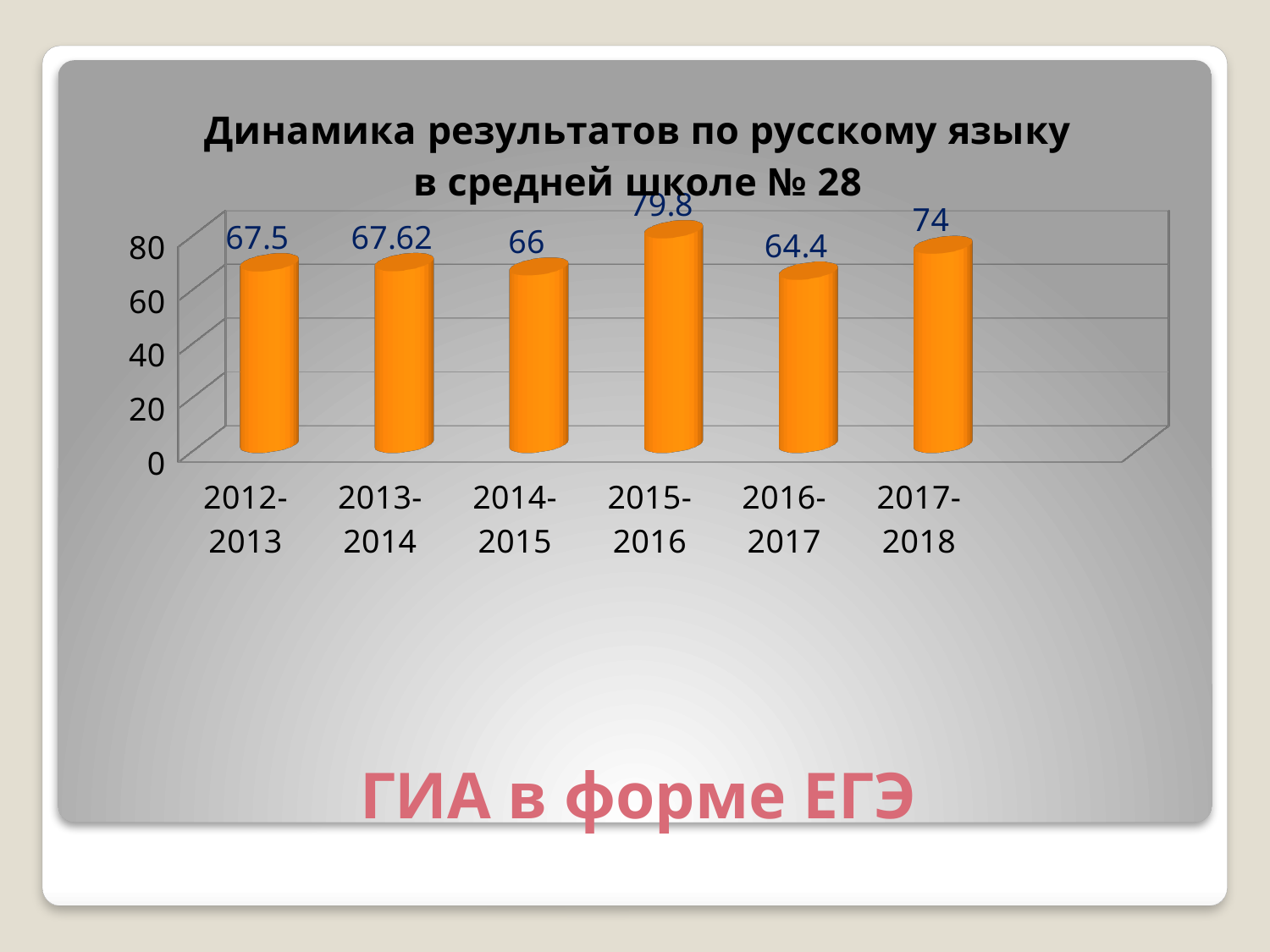
Which school year has the highest value? 2015-2016 Which school year has the lowest value? 2016-2017 What is the value for 2017-2018? 74 What kind of chart is shown on the slide? bar chart What is the difference between the values for 2015-2016 and 2016-2017? 15.4 What is the value for 2012-2013? 67.5 How many school years are shown on the chart? 6 Is the value for 2013-2014 greater or less than 60? greater What is the value for 2016-2017? 64.4 What is the value for 2015-2016? 79.8 What is the title of the chart? Динамика результатов по русскому языку в средней школе № 28 Which is larger, the value for 2014-2015 or the value for 2017-2018? 2017-2018